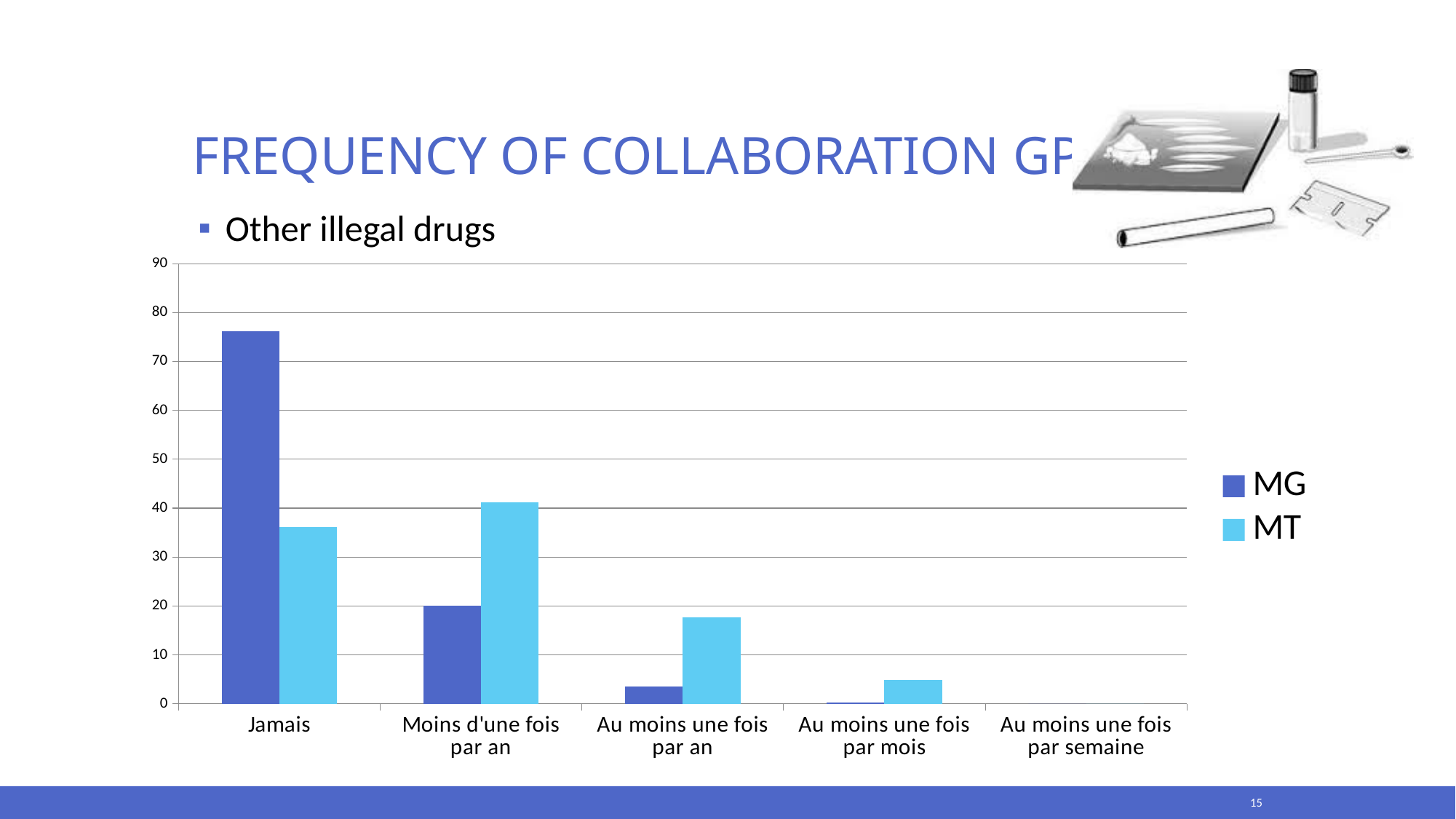
For Jamais, which series has the larger value, MG or MT? MG Which category has the highest MG value? Jamais Which category has the highest MT value? Moins d'une fois par an Is the MT value for Jamais greater or less than 40? less Is the MT value for Moins d'une fois par an greater or less than 40? greater How many categories are shown on the x axis? 5 How many series does the legend list? 2 Is the MT value for Au moins une fois par an greater or less than 20? less Do the MG values rise or fall moving from Jamais to Au moins une fois par semaine? fall What kind of chart is shown on the slide? bar chart For Au moins une fois par an, which series has the larger value, MG or MT? MT